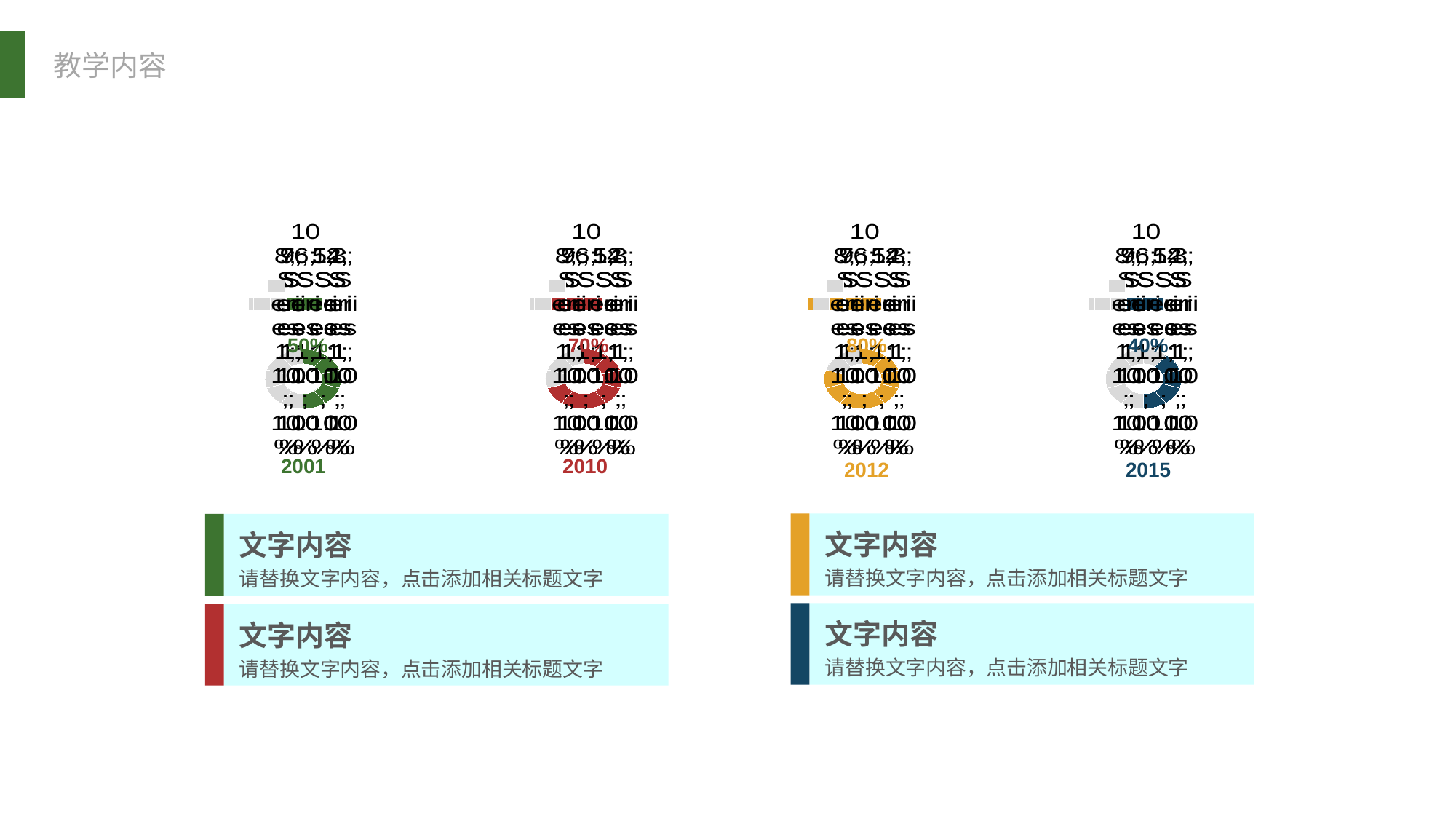
How many doughnut charts are shown on the slide? 4 Which shows a larger percentage, the 2010 chart or the 2015 chart? 2010 Which year's doughnut chart shows the lowest percentage? 2015 What percentage is shown on the doughnut chart labelled 2010? 70% Which year's doughnut chart shows the highest percentage? 2012 What colour is the filled portion of the doughnut chart labelled 2010? Red What kind of chart is used for each of the four year figures on the slide? Doughnut chart What percentage is shown on the doughnut chart labelled 2001? 50% What percentage is shown on the doughnut chart labelled 2012? 80% What percentage is shown on the doughnut chart labelled 2015? 40% What colour is the filled portion of the doughnut chart labelled 2015? Dark blue What is the difference between the percentage shown for 2012 and the percentage shown for 2001? 30%